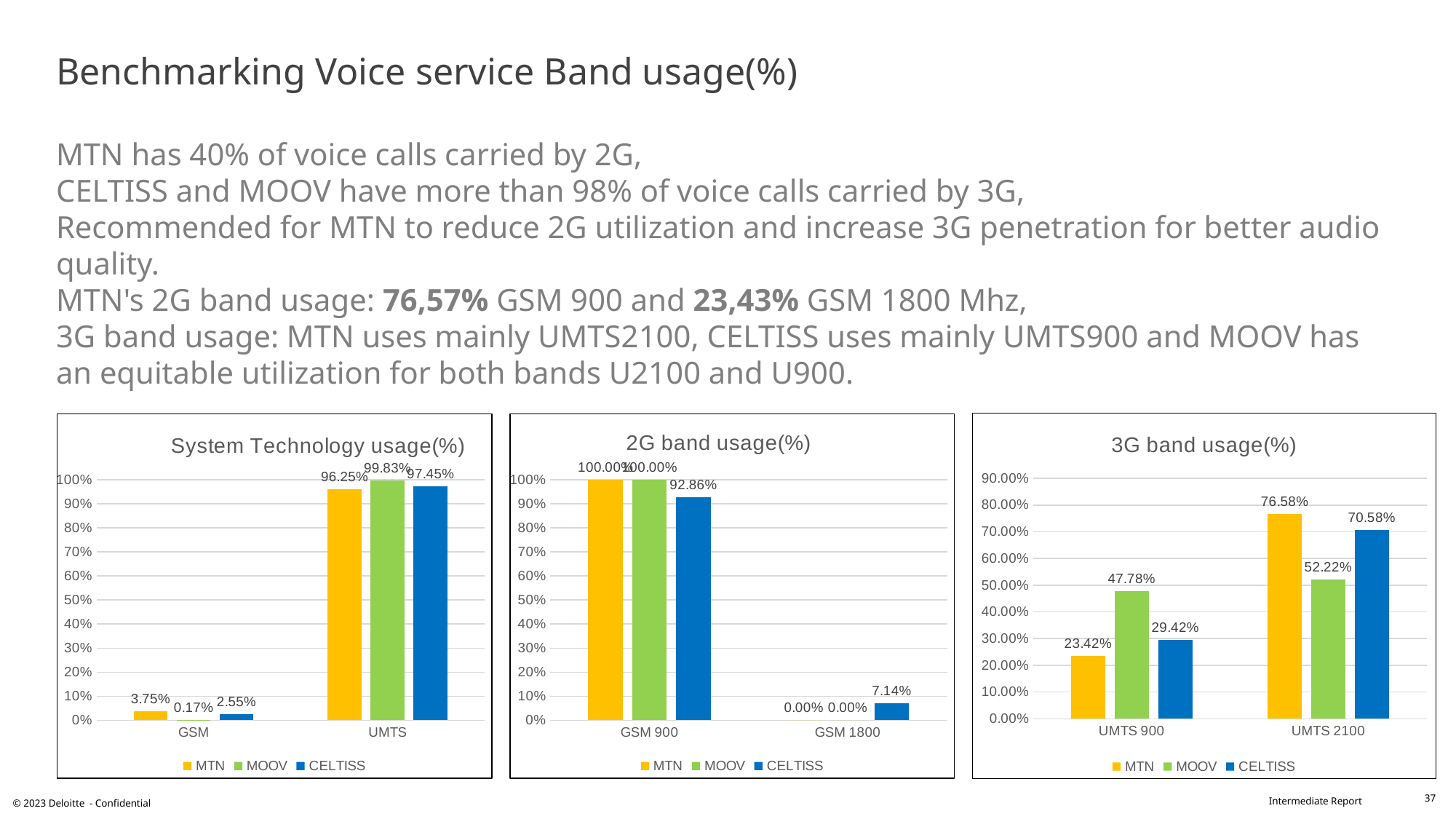
In the "System Technology usage(%)" chart, which operator has the highest value for UMTS? MOOV In the "System Technology usage(%)" chart, what is the difference between the CELTISS values for UMTS and GSM? 94.90% In the "3G band usage(%)" chart, which operator has the lowest value for UMTS 2100? MOOV In the "3G band usage(%)" chart, what is the difference between the MTN values for UMTS 2100 and UMTS 900? 53.16% In the "3G band usage(%)" chart, what is the value for MOOV in the UMTS 900 category? 47.78% In the "2G band usage(%)" chart, which operator has the highest value for GSM 1800? CELTISS How many series does the legend of the "3G band usage(%)" chart list? 3 In the "3G band usage(%)" chart, which is larger for UMTS 900: the value for CELTISS or the value for MTN? CELTISS What kind of chart is the "2G band usage(%)" chart? Bar chart In the "2G band usage(%)" chart, what is the value for MOOV in the GSM 1800 category? 0.00% In the "2G band usage(%)" chart, what is the value for CELTISS in the GSM 900 category? 92.86% In the "System Technology usage(%)" chart, what is the value for MTN in the GSM category? 3.75%